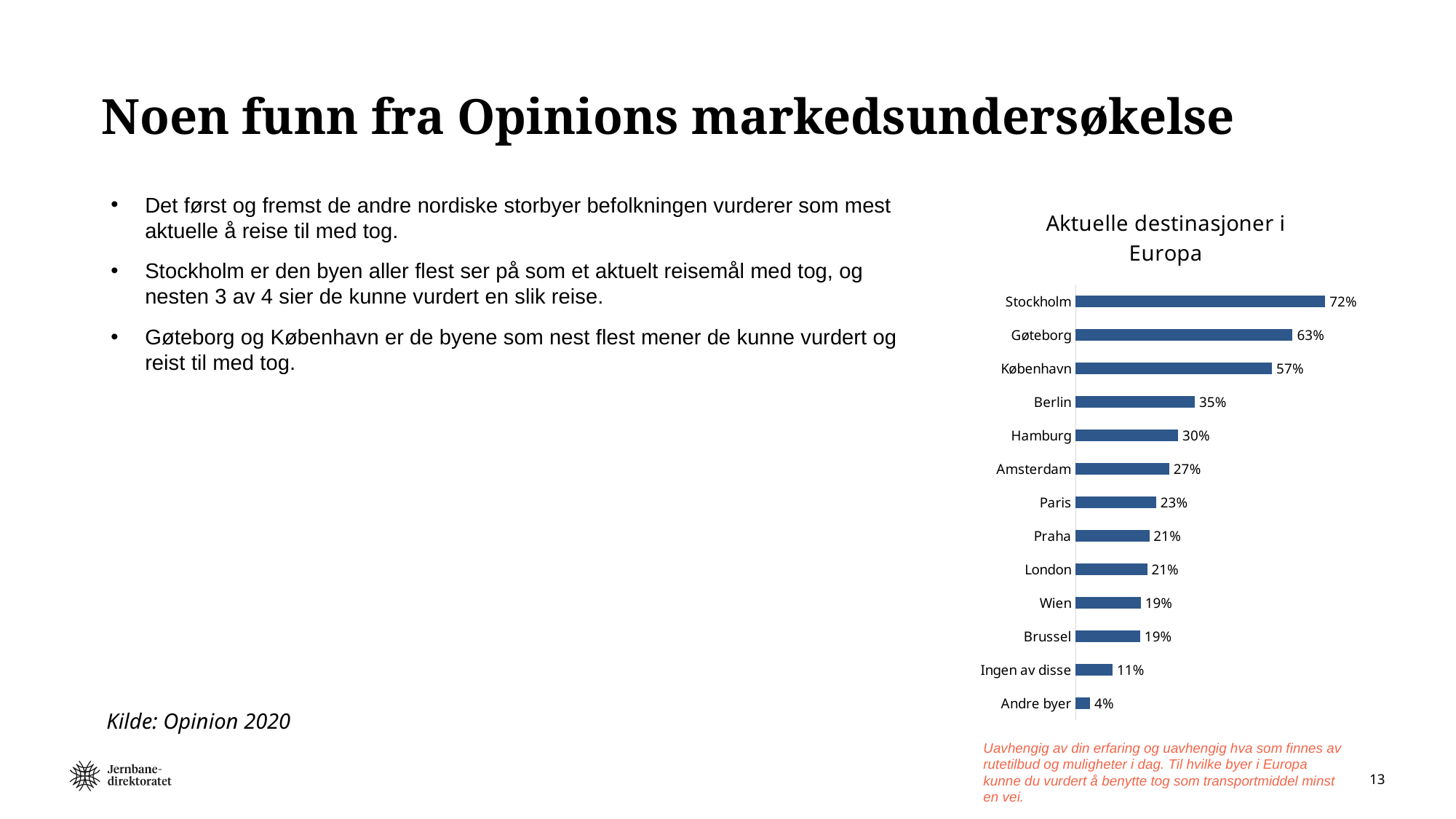
What is the title of the chart? Aktuelle destinasjoner i Europa How many categories are shown in the chart? 13 What is the difference between the values for København and Berlin? 22% Which destination has the highest value? Stockholm Which has a larger value, Hamburg or Amsterdam? Hamburg What is the value for Andre byer? 4% Which has a larger value, Paris or Wien? Paris What kind of chart is shown on the slide? Bar chart Which category has the lowest value? Andre byer What is the value for Stockholm? 72% What is the value for Berlin? 35% What is the difference between the values for Stockholm and Gøteborg? 9%